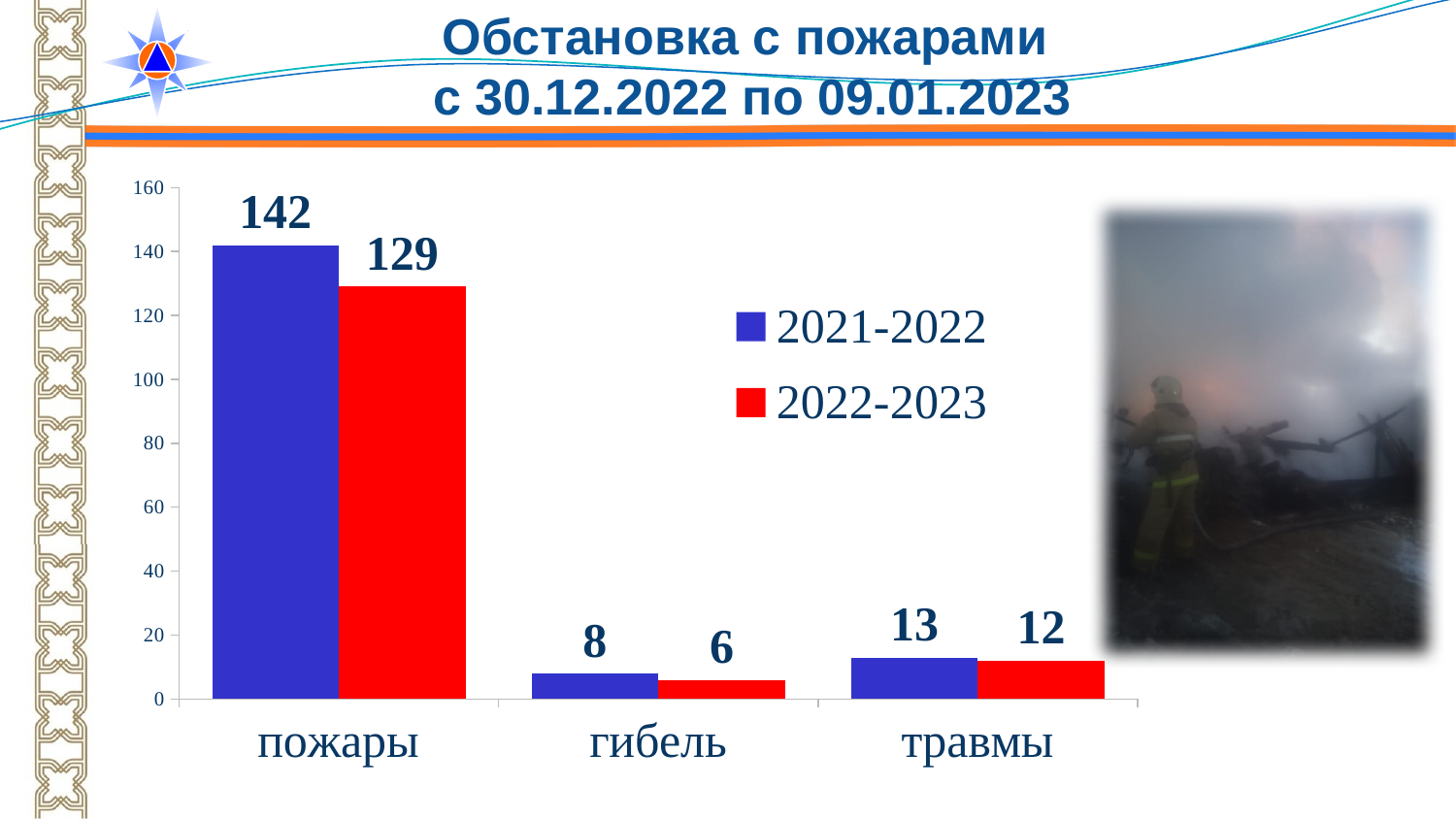
What is the value for пожары in the 2021-2022 series? 142 What kind of chart is shown on the slide? bar chart What is the difference between the 2021-2022 and 2022-2023 values for гибель? 2 Which is larger for травмы: the 2021-2022 value or the 2022-2023 value? 2021-2022 Which category has the lowest value in the 2021-2022 series? гибель Which category has the highest value in the 2022-2023 series? пожары How many series does the legend list? 2 What is the difference between the 2021-2022 and 2022-2023 values for пожары? 13 What is the value for гибель in the 2022-2023 series? 6 How many categories are shown on the x axis? 3 What is the value for травмы in the 2021-2022 series? 13 What is the value for пожары in the 2022-2023 series? 129